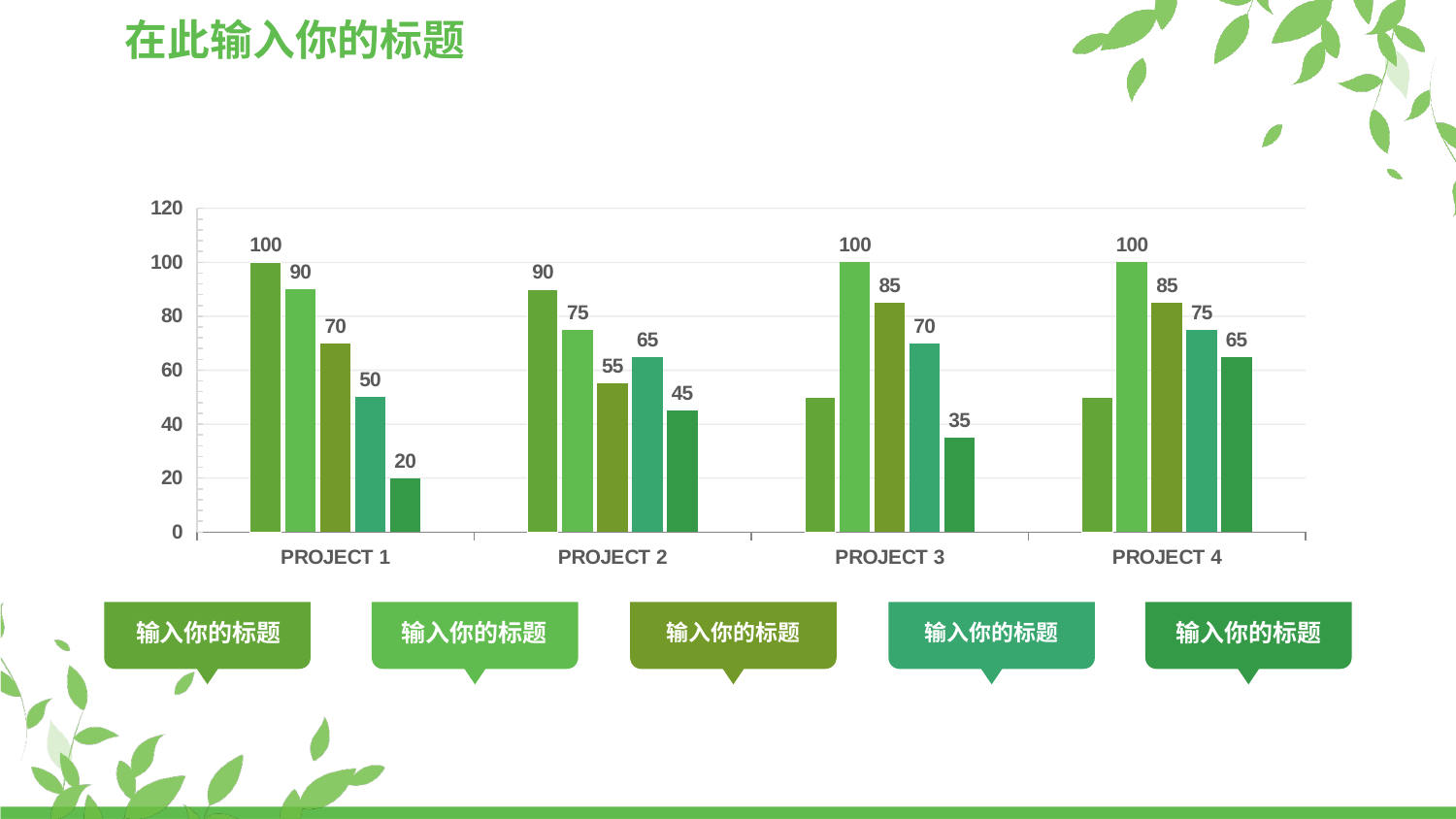
How many project categories are shown on the x axis? 4 In PROJECT 2, which is larger: the third bar (55) or the fourth bar (65)? the fourth bar (65) What is the value of the last (rightmost) bar in PROJECT 4? 65 What is the difference between the first and last bars in PROJECT 1? 80 How many bars are in each project group? 5 What is the value of the shortest bar in PROJECT 1? 20 Within PROJECT 1, do the bar values rise or fall from left to right? fall What kind of chart is shown on the slide? bar chart What is the value of the second bar in PROJECT 2? 75 What is the value of the tallest bar in PROJECT 1? 100 Is the value of the unlabeled first bar in PROJECT 3 greater or less than 40? greater What is the highest value shown on the vertical axis? 120